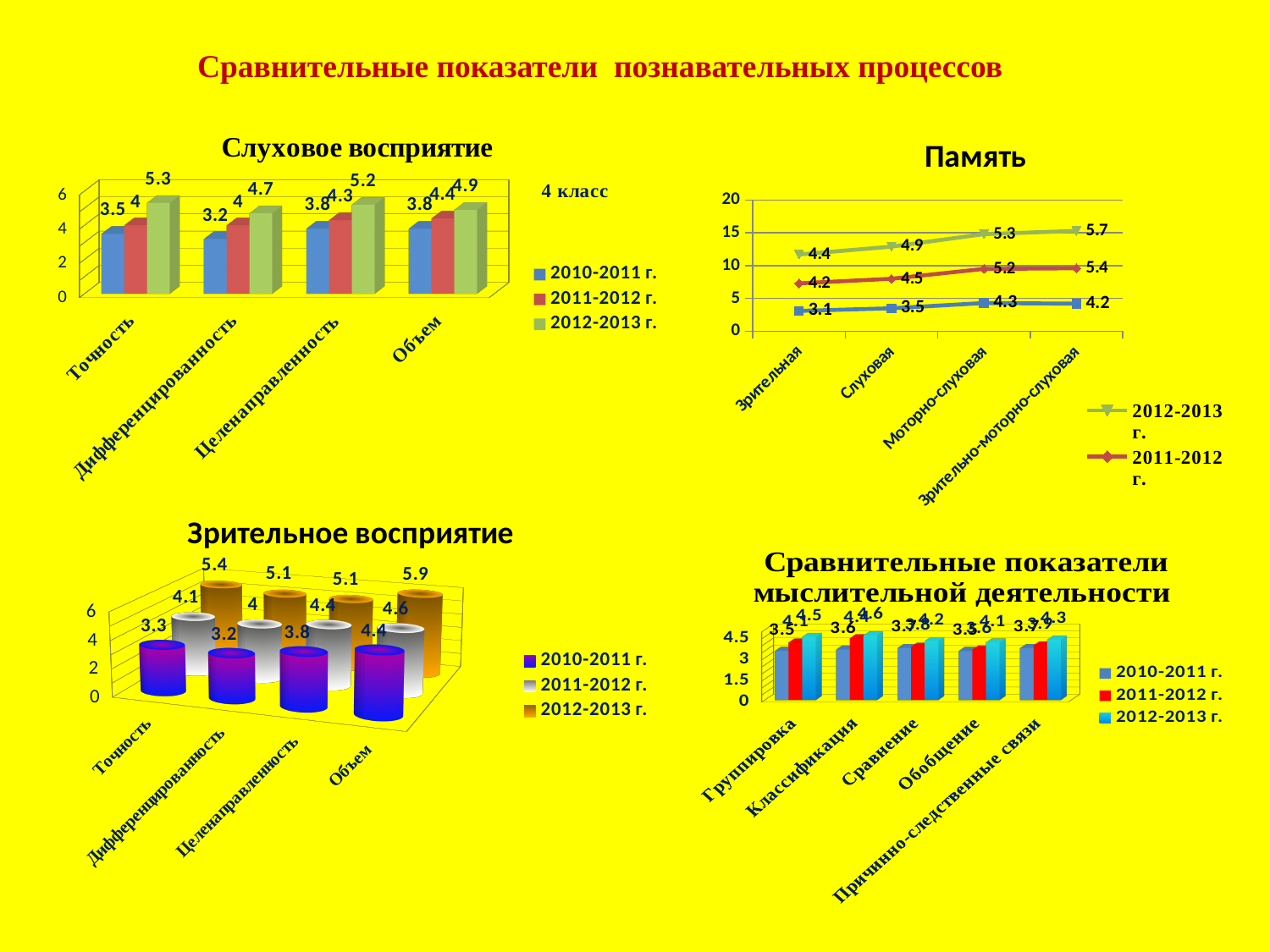
In the 'Память' chart, do the values of the 2012-2013 г. series rise or fall from Зрительная to Зрительно-моторно-слуховая? rise In the 'Память' chart, what is the value for Зрительно-моторно-слуховая in the 2012-2013 г. series? 5.7 What kind of chart is the 'Память' chart? line chart In the 'Слуховое восприятие' chart, how many series does the legend list? 3 In the 'Зрительное восприятие' chart, which is larger: the 2010-2011 г. value for Объем or the 2010-2011 г. value for Точность? Объем In the 'Слуховое восприятие' chart, which category has the lowest value in the 2010-2011 г. series? Дифференцированность In the 'Слуховое восприятие' chart, what is the value for Точность in the 2012-2013 г. series? 5.3 In the 'Зрительное восприятие' chart, which category has the highest value in the 2012-2013 г. series? Объем In the 'Зрительное восприятие' chart, what is the value for Целенаправленность in the 2011-2012 г. series? 4.4 In the 'Слуховое восприятие' chart, what is the difference between the 2012-2013 г. and 2010-2011 г. values for Точность? 1.8 In the 'Память' chart, what is the value for Зрительная in the 2011-2012 г. series? 4.2 How many categories are shown on the x axis of the 'Сравнительные показатели мыслительной деятельности' chart? 5